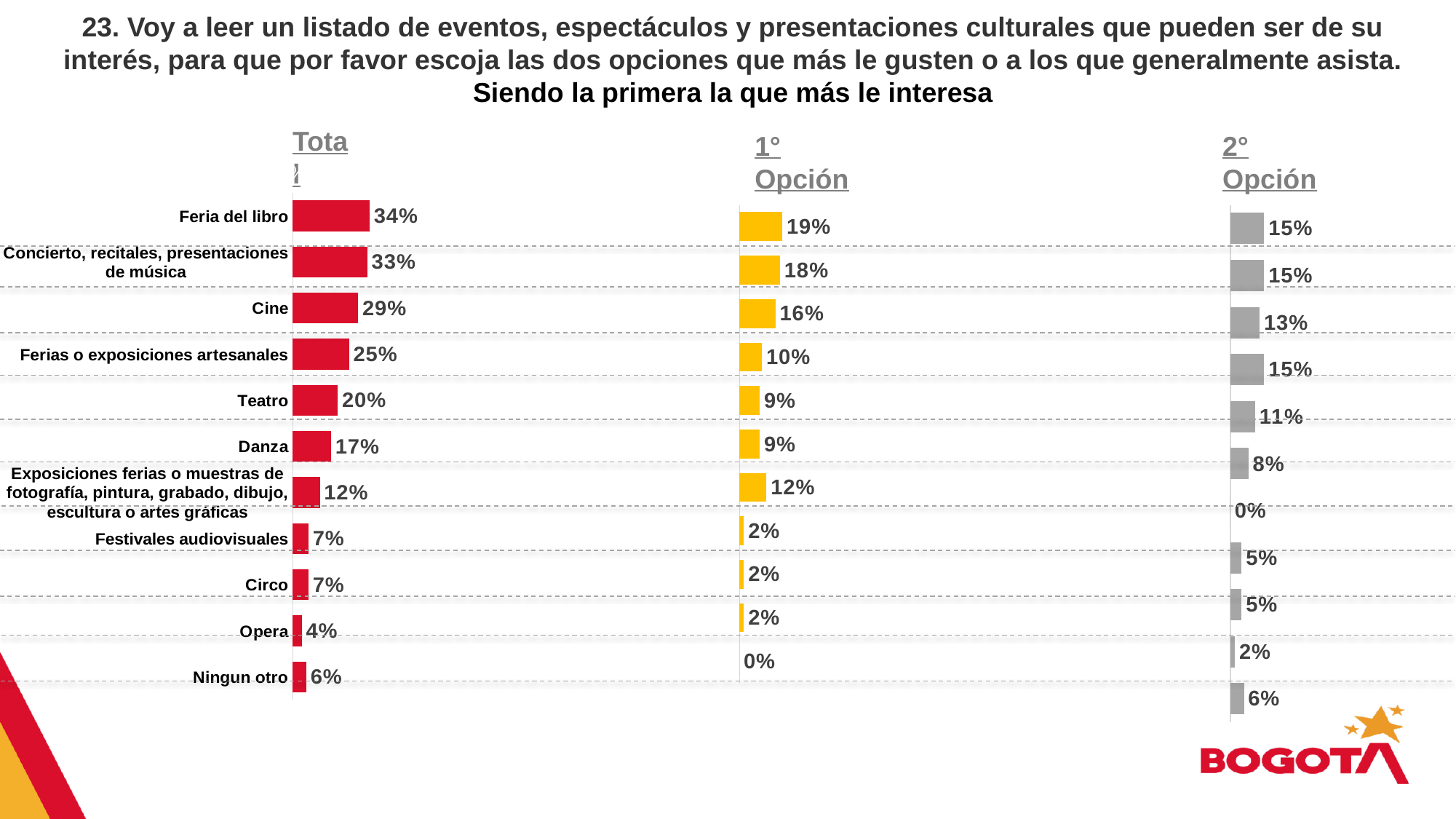
In the Total chart, which category has the highest value? Feria del libro In the Total chart, which is larger, Danza or Circo? Danza What is the highest value shown in the 2° Opción chart? 15% How many categories are shown in the Total chart? 11 What type of chart is the Total chart? Bar chart In the Total chart, what is the value for Teatro? 20% In the Total chart, what is the value for Feria del libro? 34% In the 1° Opción chart, what is the value for Cine? 16% In the Total chart, what is the difference between Feria del libro and Cine? 5% In the 1° Opción chart, which category has the highest value? Feria del libro In the Total chart, which category has the lowest value? Opera In the 1° Opción chart, what is the value for Ferias o exposiciones artesanales? 10%